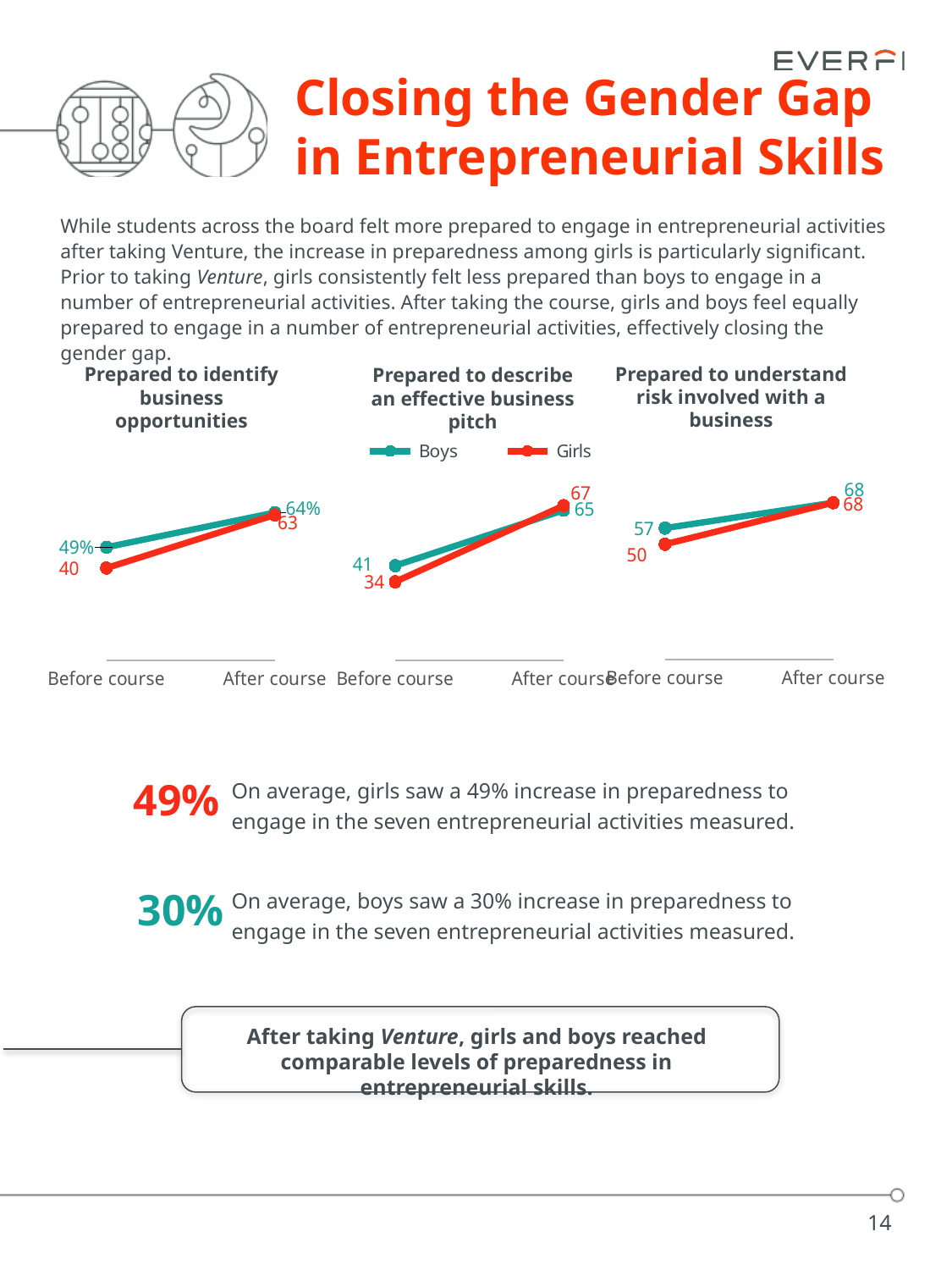
In the 'Prepared to identify business opportunities' chart, what is the value for Boys before the course? 49% In the 'Prepared to describe an effective business pitch' chart, what is the difference between the Boys and Girls values before the course? 7 Which colour represents Girls in the charts' legend? red What kind of chart is 'Prepared to describe an effective business pitch'? line chart In the 'Prepared to identify business opportunities' chart, which series has the higher value before the course, Boys or Girls? Boys In the 'Prepared to understand risk involved with a business' chart, what is the value for Boys before the course? 57 In the 'Prepared to describe an effective business pitch' chart, what is the value for Girls before the course? 34 In the 'Prepared to describe an effective business pitch' chart, what is the value for Boys after the course? 65 In the 'Prepared to understand risk involved with a business' chart, what is the value for Girls after the course? 68 How many series does the legend list for the charts? 2 In the 'Prepared to understand risk involved with a business' chart, do the Girls values rise or fall from before the course to after the course? rise In the 'Prepared to identify business opportunities' chart, what is the value for Girls after the course? 63